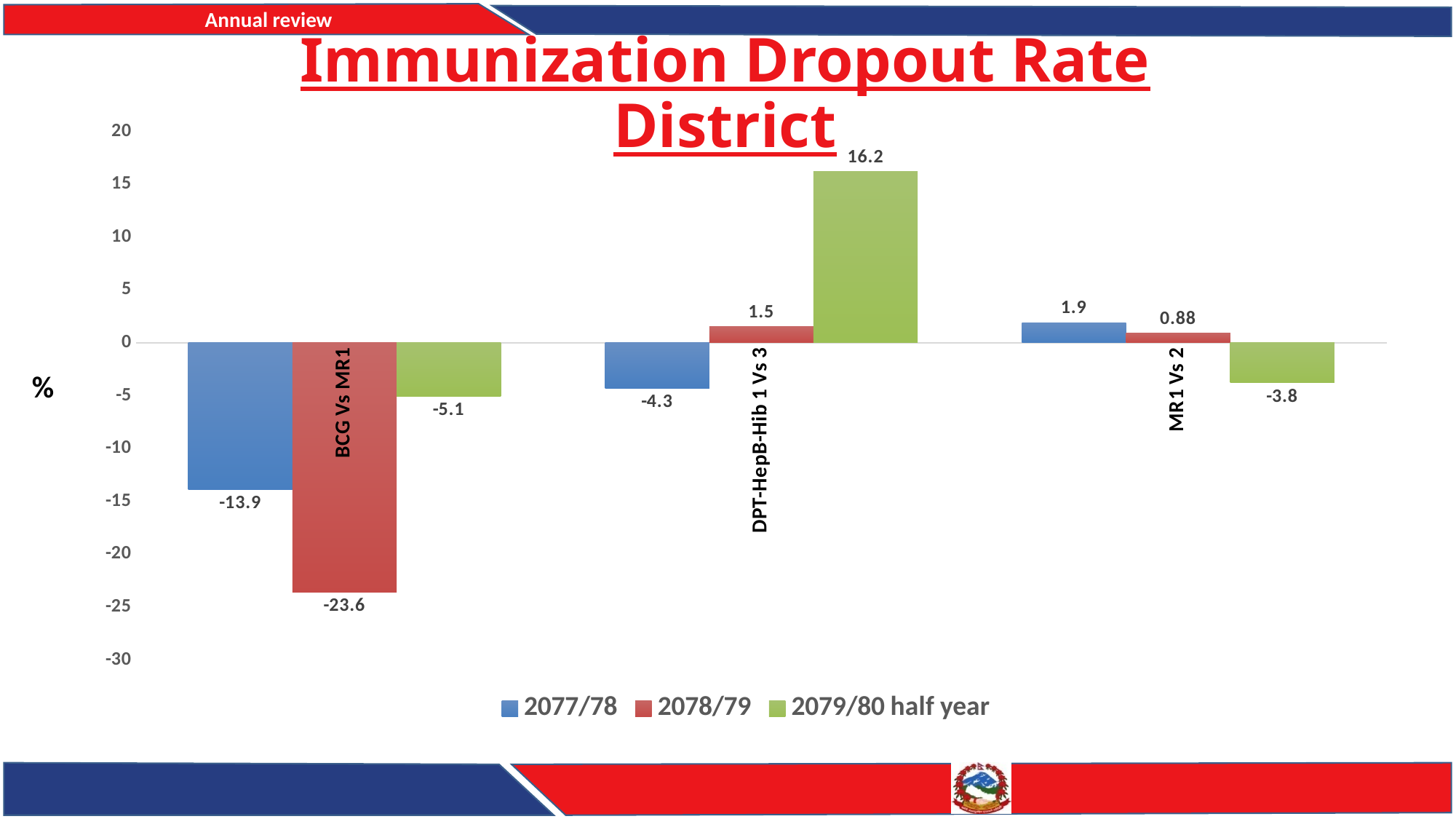
Which category has the lowest 2077/78 value? BCG Vs MR1 Which is larger for BCG Vs MR1: the 2077/78 value or the 2079/80 half year value? 2079/80 half year What kind of chart is shown on the slide? Bar chart What is the 2079/80 half year value for DPT-HepB-Hib 1 Vs 3? 16.2 What is the 2078/79 value for BCG Vs MR1? -23.6 What is the 2077/78 value for MR1 Vs 2? 1.9 How many categories are shown on the x axis? 3 What is the difference between the 2079/80 half year value for DPT-HepB-Hib 1 Vs 3 and the 2078/79 value for DPT-HepB-Hib 1 Vs 3? 14.7 How many series does the legend list? 3 What is the title of the chart? Immunization Dropout Rate District Which category has the highest 2079/80 half year value? DPT-HepB-Hib 1 Vs 3 What is the 2078/79 value for MR1 Vs 2? 0.88